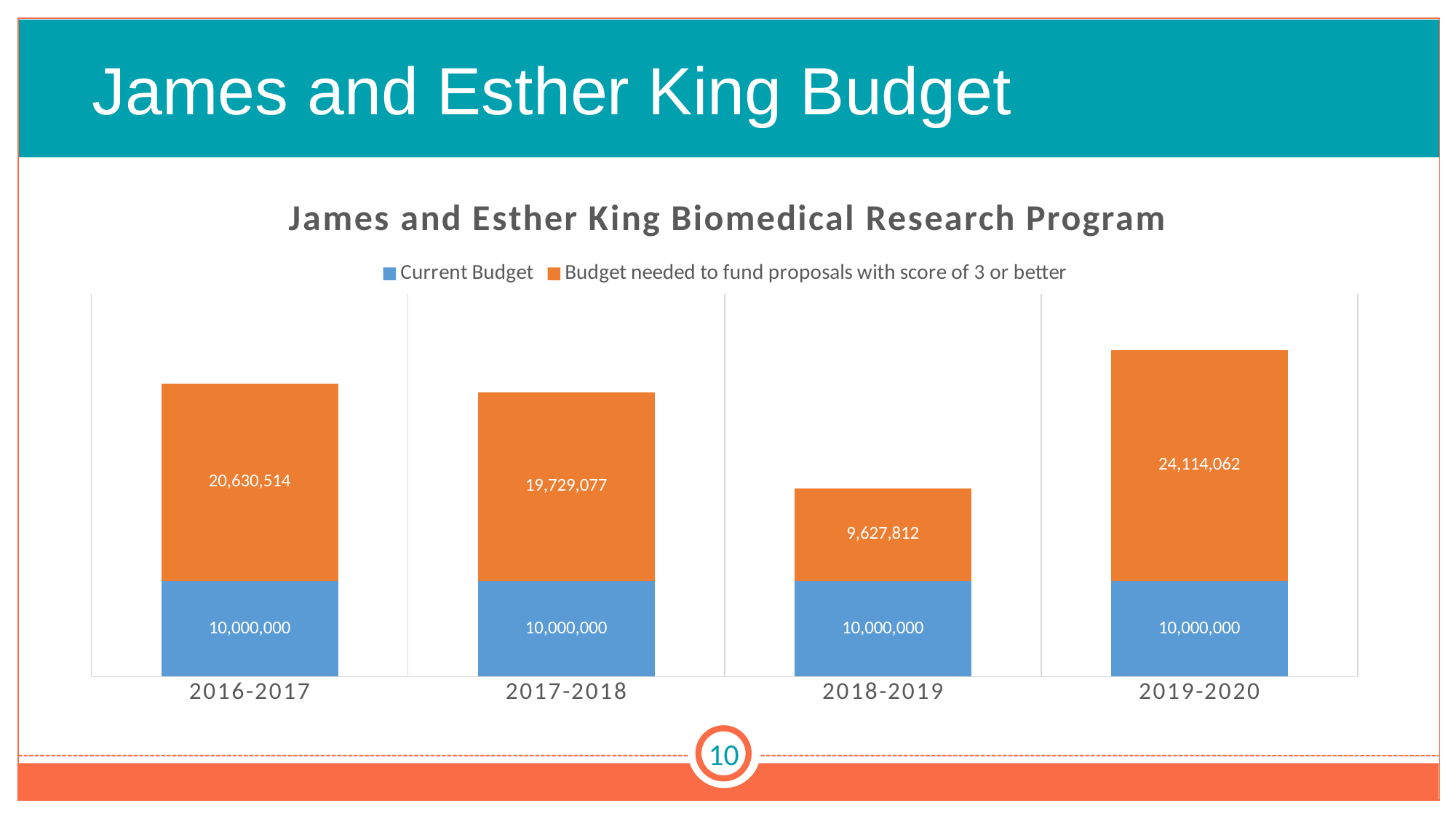
Which year has the lowest 'Budget needed to fund proposals with score of 3 or better'? 2018-2019 What is the value of 'Budget needed to fund proposals with score of 3 or better' for 2019-2020? 24,114,062 What is the difference between the 'Budget needed to fund proposals with score of 3 or better' in 2019-2020 and in 2018-2019? 14,486,250 What is the value of 'Budget needed to fund proposals with score of 3 or better' for 2018-2019? 9,627,812 Which year has the highest 'Budget needed to fund proposals with score of 3 or better'? 2019-2020 How many series does the chart legend list? 2 What is the total of the stacked bar for 2018-2019? 19,627,812 How many years are shown on the x axis of the chart? 4 What is the total of the stacked bar for 2019-2020? 34,114,062 What type of chart is shown on the slide? Stacked bar chart Is the 'Budget needed to fund proposals with score of 3 or better' larger in 2016-2017 or in 2017-2018? 2016-2017 What is the 'Current Budget' value for 2017-2018? 10,000,000